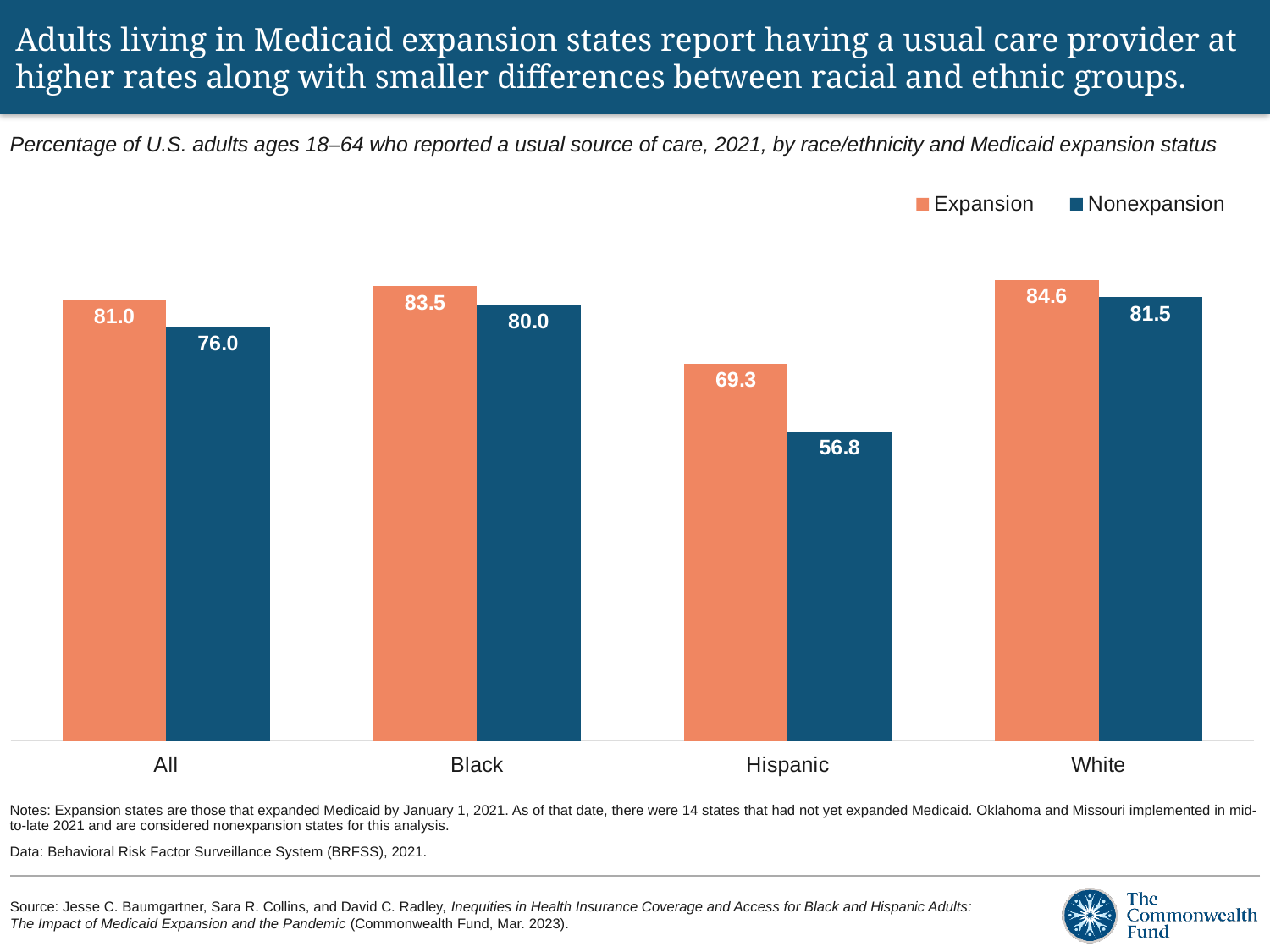
Which is larger: the Expansion value for Black adults or the Nonexpansion value for White adults? Expansion value for Black adults How many series does the legend list? 2 Which category has the lowest Nonexpansion value? Hispanic How many categories are shown on the x axis? 4 What is the Nonexpansion value for Black adults? 80.0 Which racial/ethnic category has the highest Expansion value? White Which colour represents the Nonexpansion series? Dark blue What is the Expansion value for Hispanic adults? 69.3 What kind of chart is shown on the slide? Bar chart What is the Nonexpansion value for the All category? 76.0 What is the difference between the Expansion and Nonexpansion values for White adults? 3.1 What is the difference between the Expansion and Nonexpansion values for Hispanic adults? 12.5